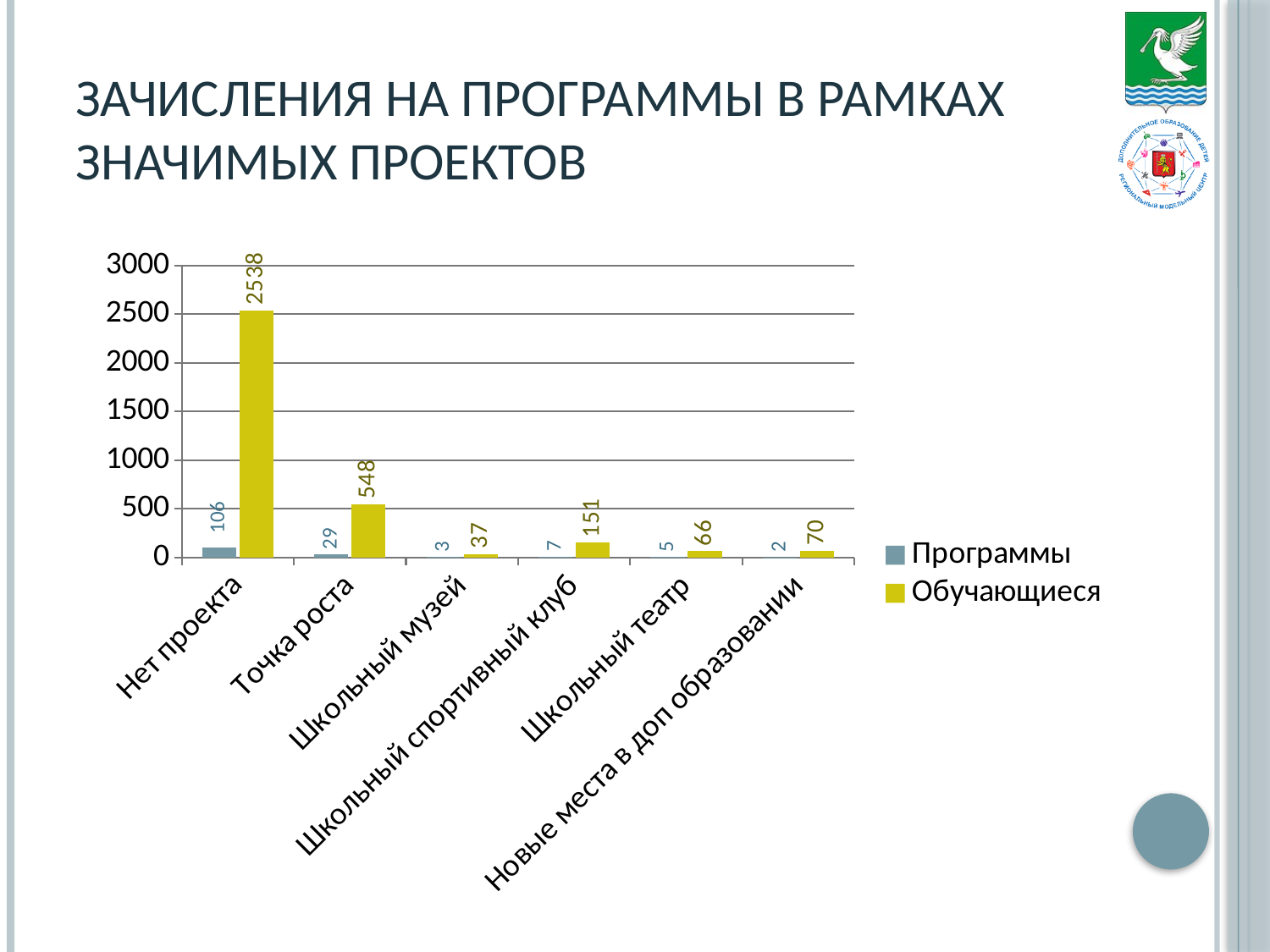
What is the value of Обучающиеся for Нет проекта? 2538 Which is larger: Обучающиеся for Школьный театр or Обучающиеся for Новые места в доп образовании? Новые места в доп образовании Which category has the lowest value for Программы? Новые места в доп образовании Which category has the highest value for Обучающиеся? Нет проекта What is the value of Обучающиеся for Школьный спортивный клуб? 151 What is the value of Программы for Точка роста? 29 How many categories are shown on the x axis? 6 What is the value of Программы for Новые места в доп образовании? 2 How many series does the legend list? 2 What is the difference between Обучающиеся for Точка роста and Обучающиеся for Школьный театр? 482 Which series is shown in yellow in the legend? Обучающиеся What type of chart is shown on the slide? bar chart